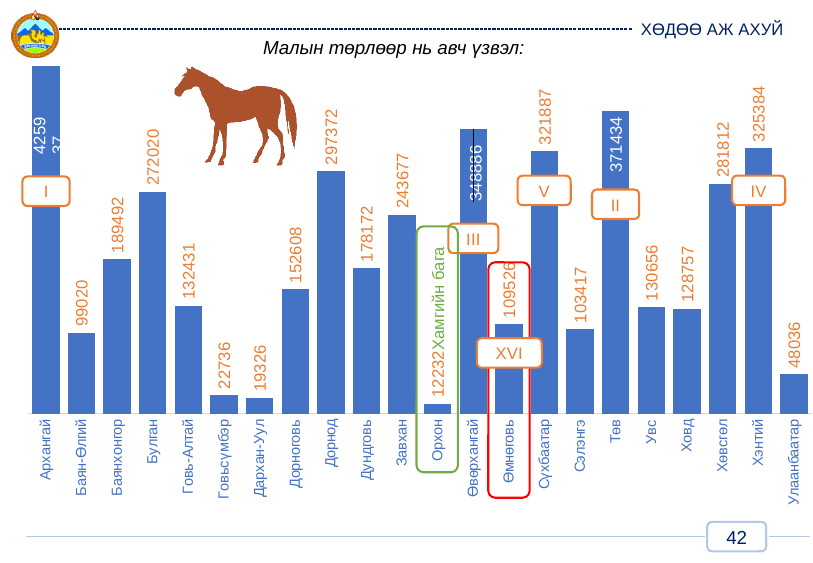
What type of chart is shown on the slide? bar chart Which category has the lowest value? Орхон What is the value for Хэнтий? 325384 What is the value for Төв? 371434 What is the difference between the values for Сүхбаатар and Хэнтий? 3497 Which is larger, the value for Дорнод or the value for Булган? Дорнод Which category has the highest value? Архангай How many categories are shown on the x axis? 22 What is the value for Улаанбаатар? 48036 What is the value for Говьсүмбэр? 22736 What is the value for Орхон? 12232 Which category is marked with the label XVI? Өмнөговь